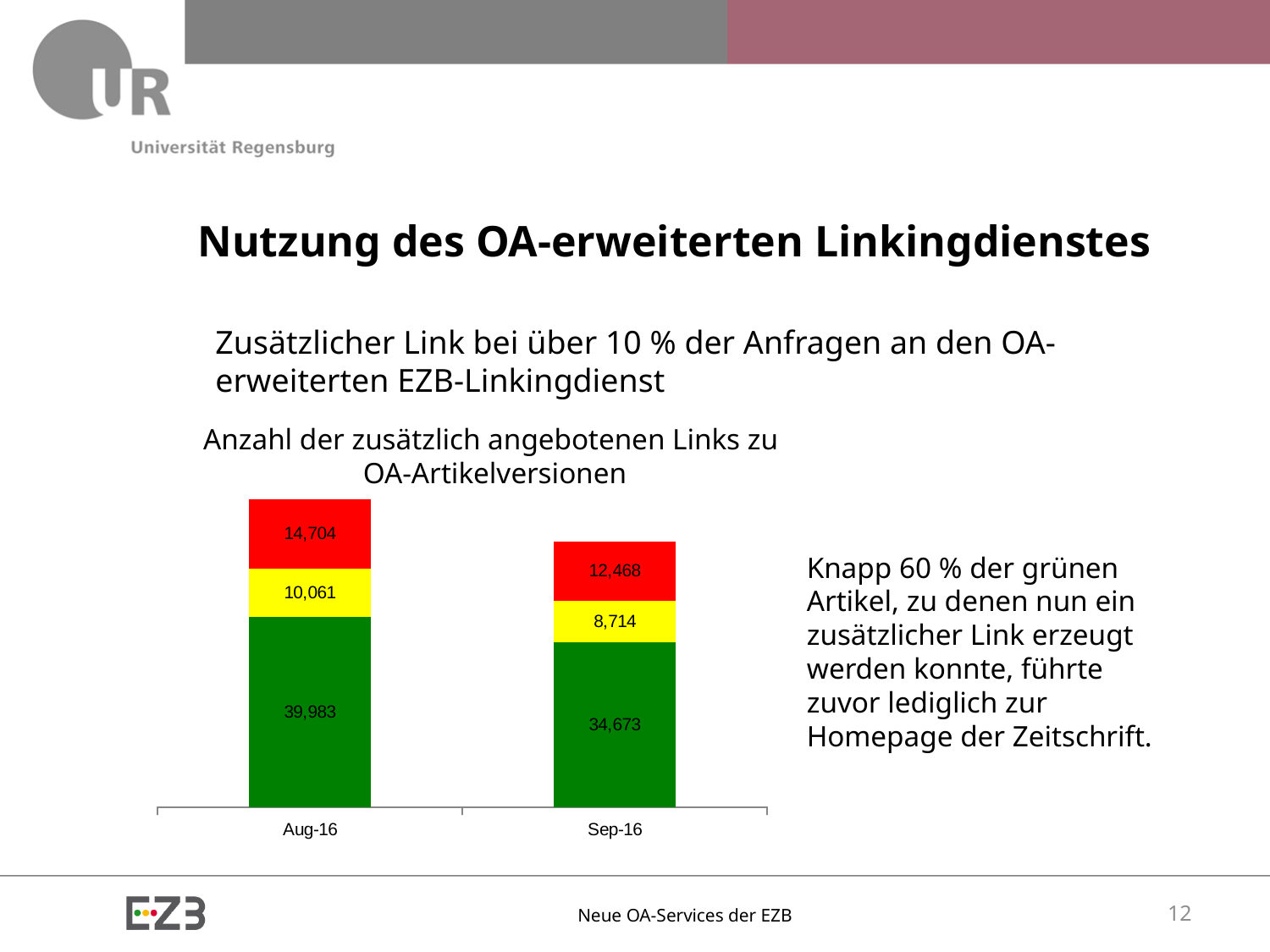
What is the total of the stacked bar for Sep-16? 55,855 What is the total of the stacked bar for Aug-16? 64,748 Which month has the larger red segment, Aug-16 or Sep-16? Aug-16 How many categories are shown on the x axis? 2 What is the value of the green segment for Aug-16? 39,983 What kind of chart is shown on the slide? Stacked bar chart What is the value of the red segment for Sep-16? 12,468 What is the difference between the green segment values for Aug-16 and Sep-16? 5,310 What is the value of the yellow segment for Sep-16? 8,714 What is the title of the chart? Anzahl der zusätzlich angebotenen Links zu OA-Artikelversionen What is the value of the yellow segment for Aug-16? 10,061 What is the difference between the red segment values for Aug-16 and Sep-16? 2,236